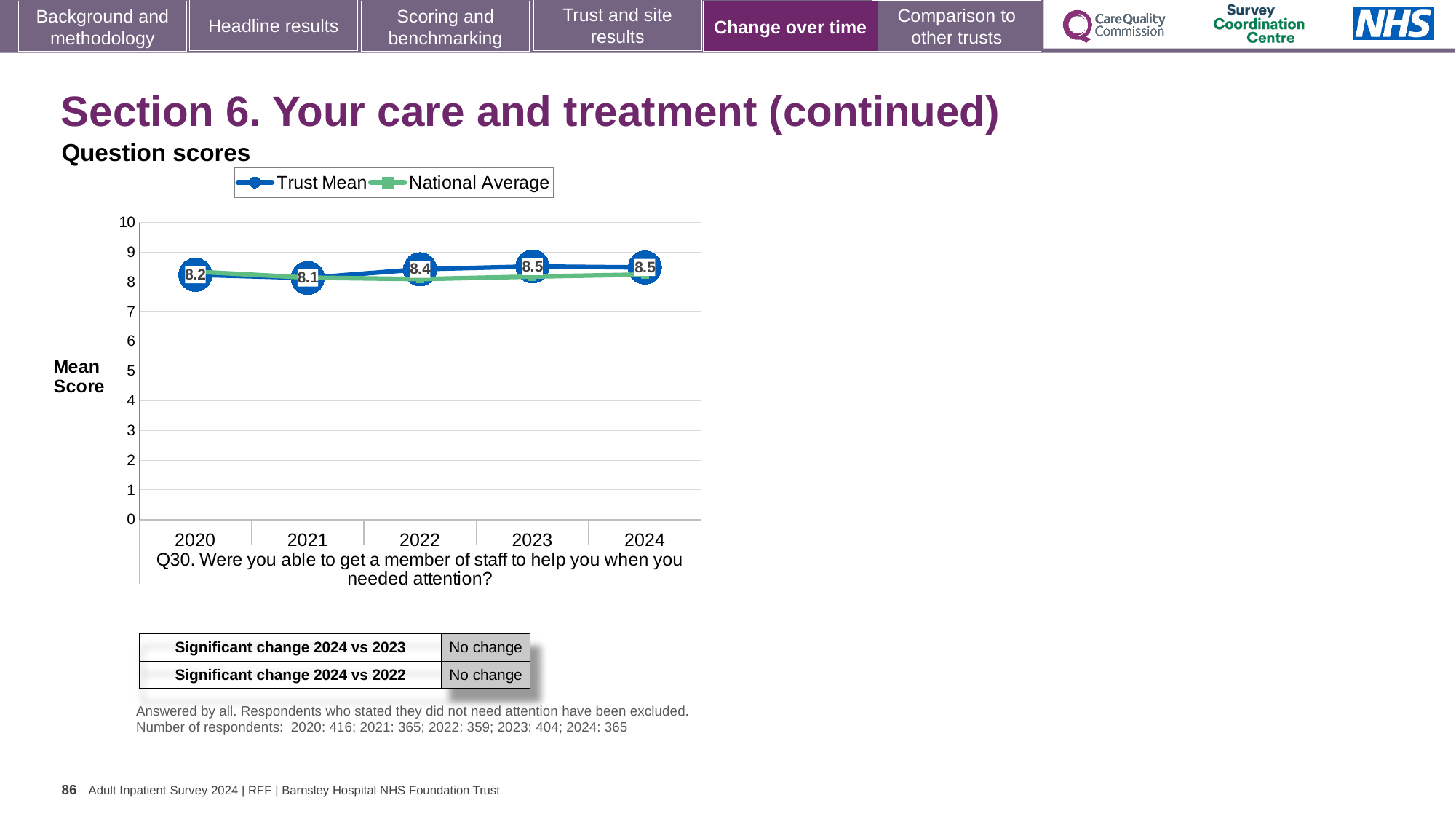
What is the Trust Mean score for 2024? 8.5 What is the Trust Mean score for 2022? 8.4 Which is larger, the Trust Mean score for 2022 or for 2021? 2022 What is the Trust Mean score for 2020? 8.2 What kind of chart is shown on the slide? line chart Does the Trust Mean score rise or fall from 2021 to 2024? rise How many years are plotted on the x axis? 5 Is the National Average value for 2020 greater or less than 5? greater What is the difference between the Trust Mean score in 2024 and in 2020? 0.3 In which year is the Trust Mean score lowest? 2021 How many series does the legend list? 2 What is the label on the y axis of the chart? Mean Score